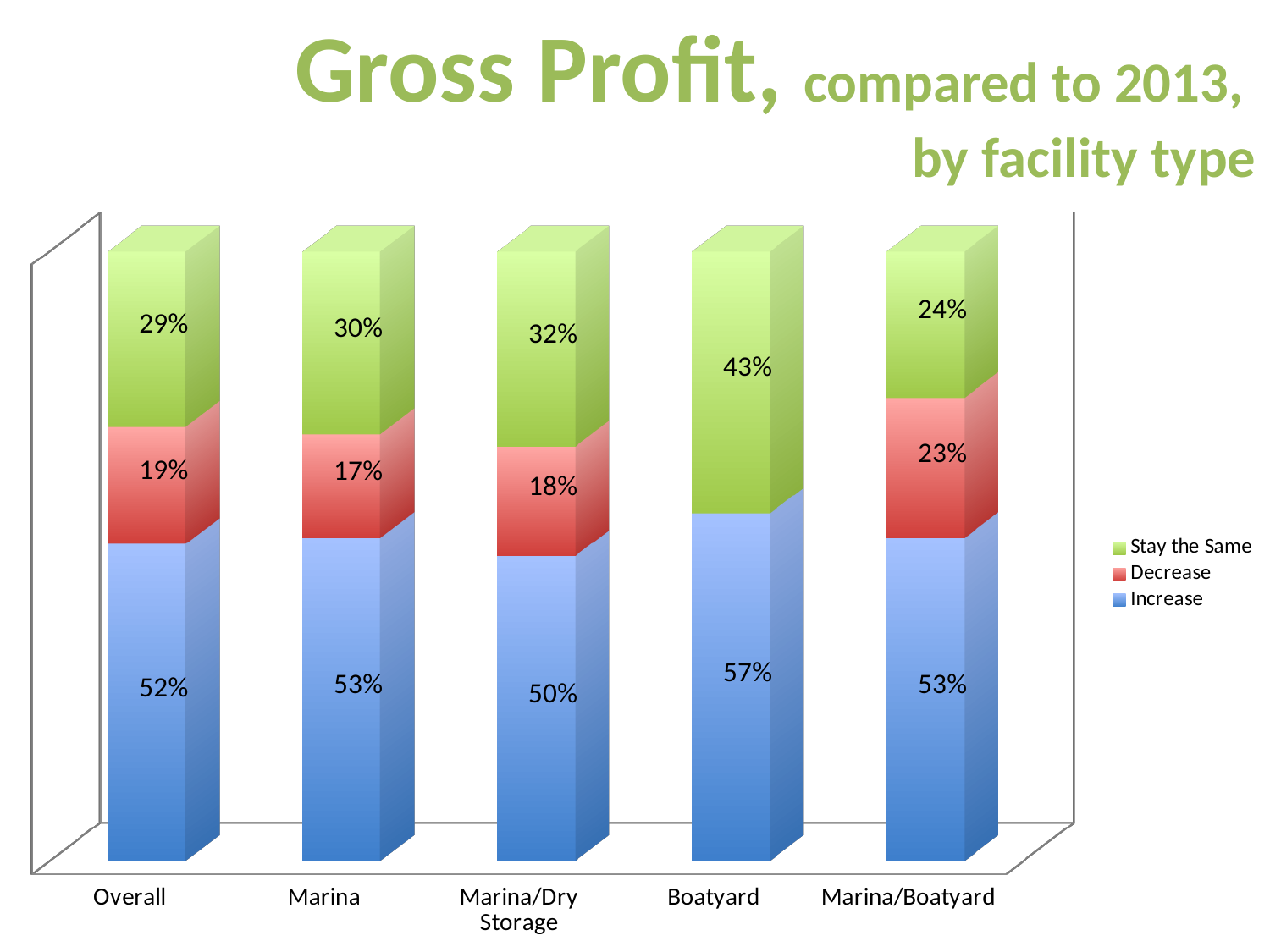
Which series is shown in green in the legend? Stay the Same What kind of chart is shown on the slide? Stacked bar chart What percentage of Boatyard respondents reported an Increase in gross profit? 57% What is the difference between the Stay the Same values for Boatyard and Marina? 13% What is the Stay the Same value for Marina/Dry Storage? 32% Which is larger, the Decrease value for Marina or the Decrease value for Marina/Boatyard? Marina/Boatyard What is the Increase value for Overall? 52% How many facility type categories are shown on the x axis? 5 How many series does the legend list? 3 Which facility type has the highest Increase value? Boatyard Which facility type has the lowest Stay the Same value? Marina/Boatyard What is the Decrease value for Marina/Boatyard? 23%